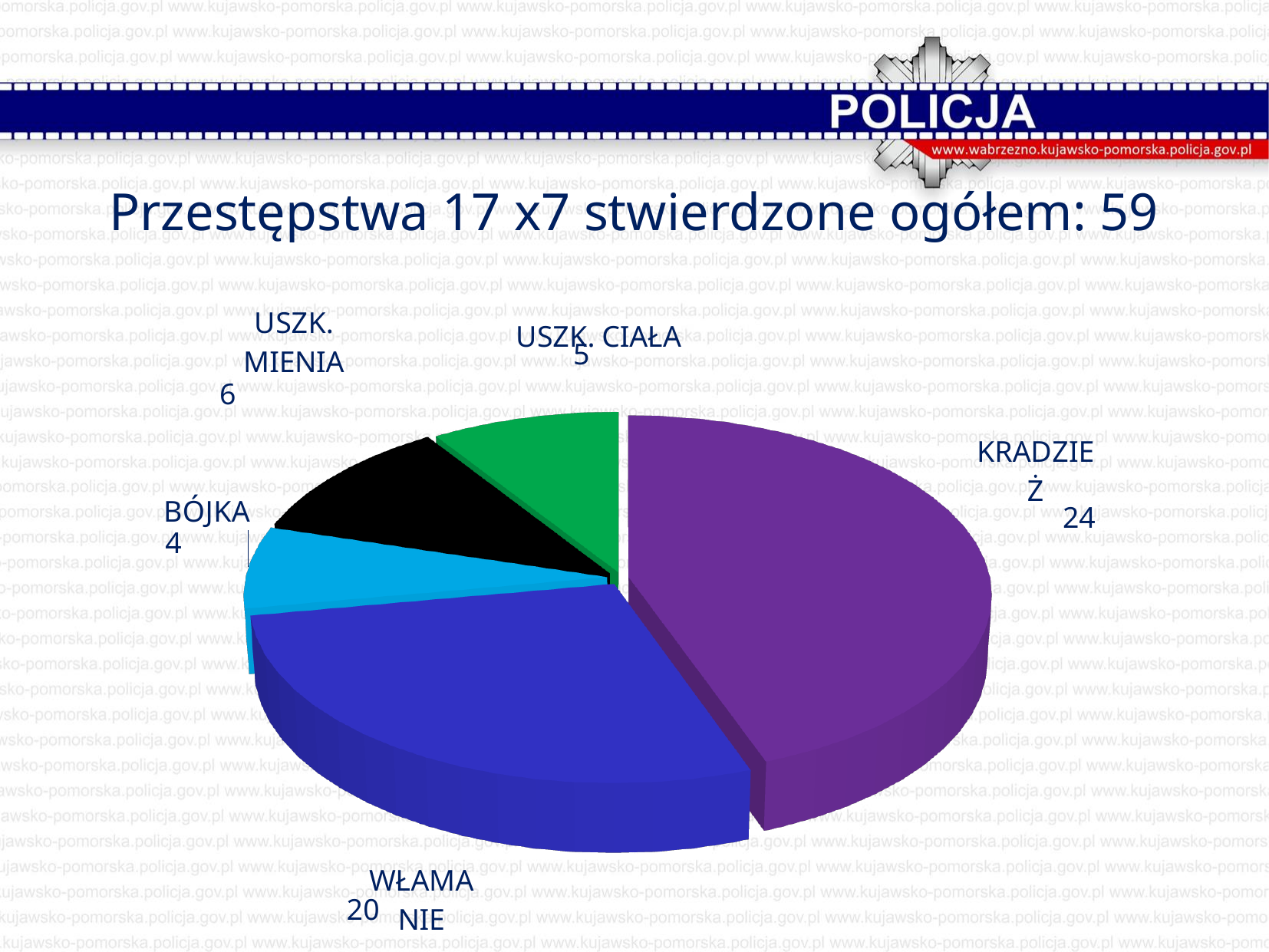
What is the value for WŁAMANIE in the pie chart? 20 What is the value for KRADZIEŻ in the pie chart? 24 What is the value for BÓJKA in the pie chart? 4 How many categories are shown in the pie chart? 5 Which is larger, USZK. MIENIA or USZK. CIAŁA? USZK. MIENIA Which category has the largest slice in the pie chart? KRADZIEŻ What is the title of the slide above the chart? Przestępstwa 17 x7 stwierdzone ogółem: 59 What is the value for USZK. CIAŁA in the pie chart? 5 Which category has the smallest slice in the pie chart? BÓJKA What is the value for USZK. MIENIA in the pie chart? 6 What is the difference between the values for KRADZIEŻ and WŁAMANIE? 4 What kind of chart is shown on the slide? pie chart